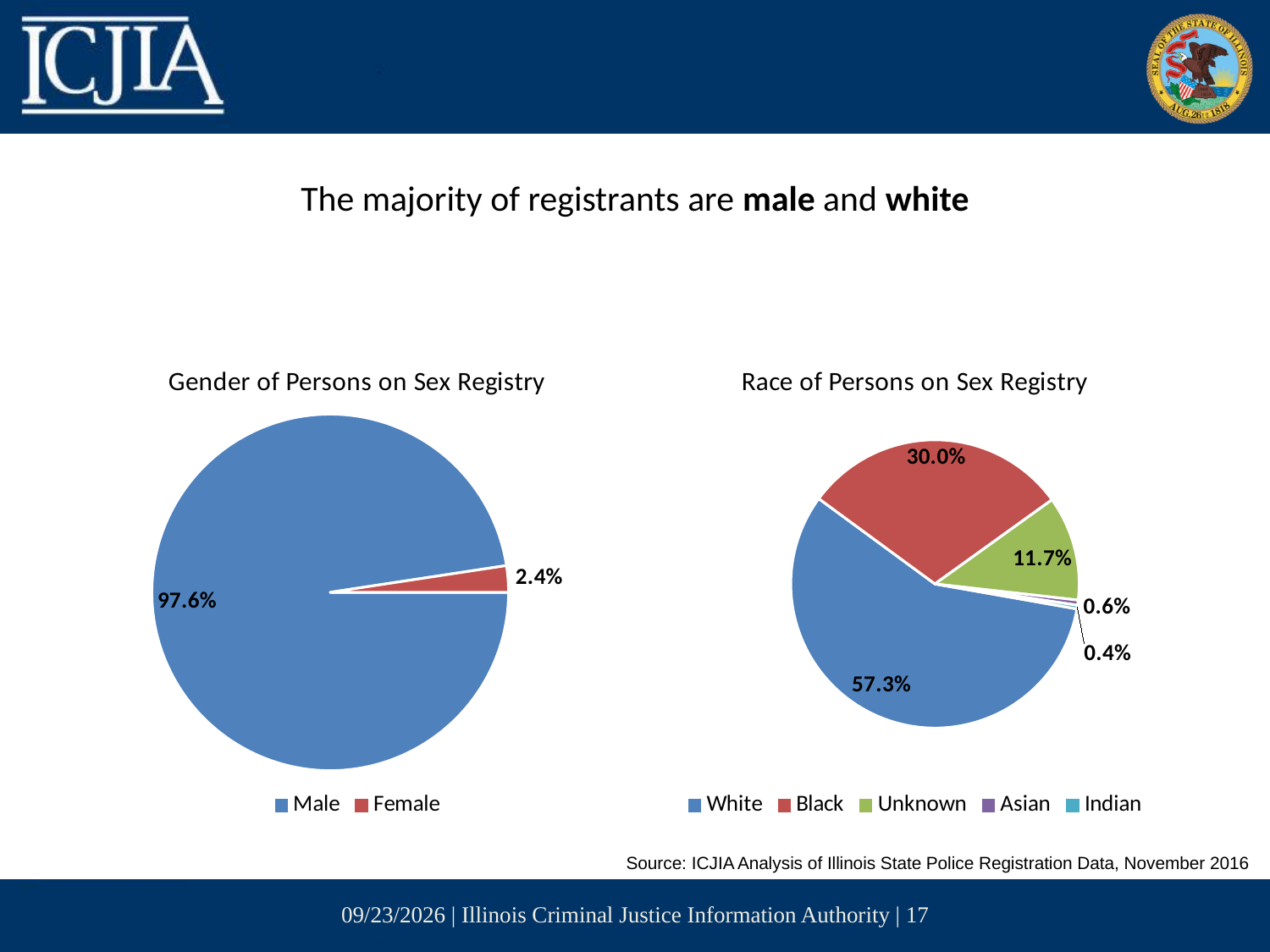
In the Race of Persons on Sex Registry chart, what is the difference in percentage points between the White and Black shares? 27.3 In the Gender of Persons on Sex Registry chart, what is the difference in percentage points between the Male and Female shares? 95.2 In the Race of Persons on Sex Registry chart, which is larger, the Black share or the Unknown share? Black In the Race of Persons on Sex Registry chart, which race category has the largest share? White In the Race of Persons on Sex Registry chart, what percentage of registrants are black? 30.0% What type of chart is the Gender of Persons on Sex Registry chart? Pie chart In the Race of Persons on Sex Registry chart, what percentage of registrants are white? 57.3% In the Gender of Persons on Sex Registry chart, what percentage of registrants are male? 97.6% In the Race of Persons on Sex Registry chart, what percentage of registrants have an unknown race? 11.7% In the Race of Persons on Sex Registry chart, which race category has the smallest share? Indian In the Gender of Persons on Sex Registry chart, what percentage of registrants are female? 2.4% How many categories does the legend of the Race of Persons on Sex Registry chart list? 5